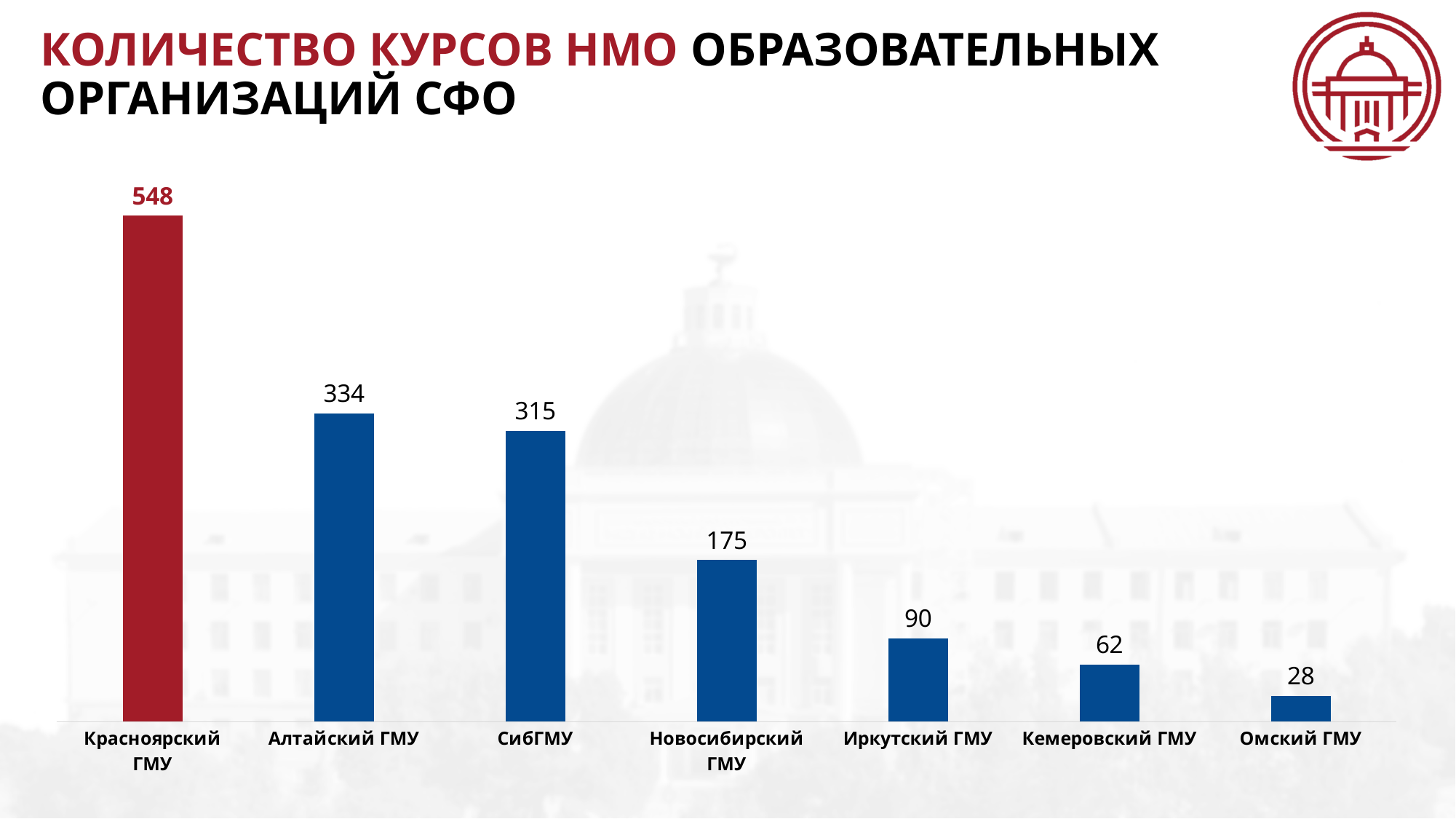
Which bar is coloured red rather than blue? Красноярский ГМУ What is the value shown for СибГМУ? 315 How many organisations are shown in the chart? 7 What kind of chart is shown on the slide? Bar chart What is the difference between the values for Красноярский ГМУ and Алтайский ГМУ? 214 Which has more NMO courses, Алтайский ГМУ or СибГМУ? Алтайский ГМУ Which organisation has the lowest number of NMO courses? Омский ГМУ Which organisation has the highest number of NMO courses? Красноярский ГМУ How many NMO courses does Красноярский ГМУ have? 548 What is the value shown for Омский ГМУ? 28 Which has more NMO courses, Кемеровский ГМУ or Иркутский ГМУ? Иркутский ГМУ What is the difference between the values for Новосибирский ГМУ and Иркутский ГМУ? 85